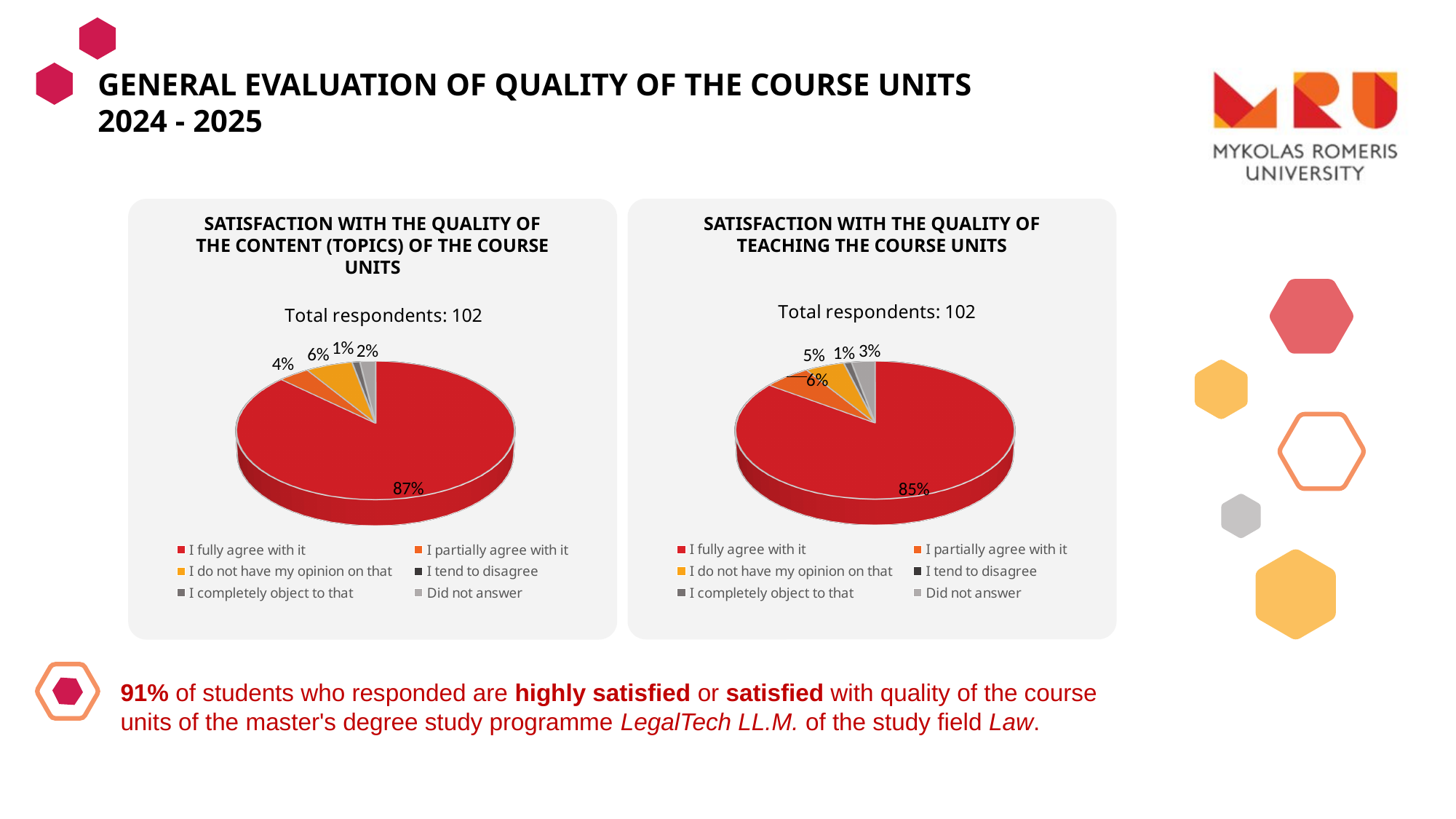
In the left chart (content of the course units), what percentage of respondents chose 'I partially agree with it'? 4% How many total respondents are reported for the chart on the right? 102 Which chart has the larger share for 'I fully agree with it': the content chart on the left or the teaching chart on the right? The content chart on the left What is the difference in percentage points between the 'I fully agree with it' share in the left chart and in the right chart? 2 percentage points In the left chart (content of the course units), which is larger: the share for 'I partially agree with it' or the share for 'I do not have my opinion on that'? I do not have my opinion on that What type of chart is used on this slide to show satisfaction with the quality of the course units? Pie chart In the chart titled 'Satisfaction with the quality of the content (topics) of the course units', what percentage of respondents chose 'I fully agree with it'? 87% How many entries does the legend of the left chart list? 6 In the right chart (teaching the course units), which response category has the largest share? I fully agree with it In the chart titled 'Satisfaction with the quality of teaching the course units', what percentage of respondents chose 'I fully agree with it'? 85% In the left chart (content of the course units), which response category has the largest share? I fully agree with it In the left chart (content of the course units), what percentage of respondents chose 'I do not have my opinion on that'? 6%